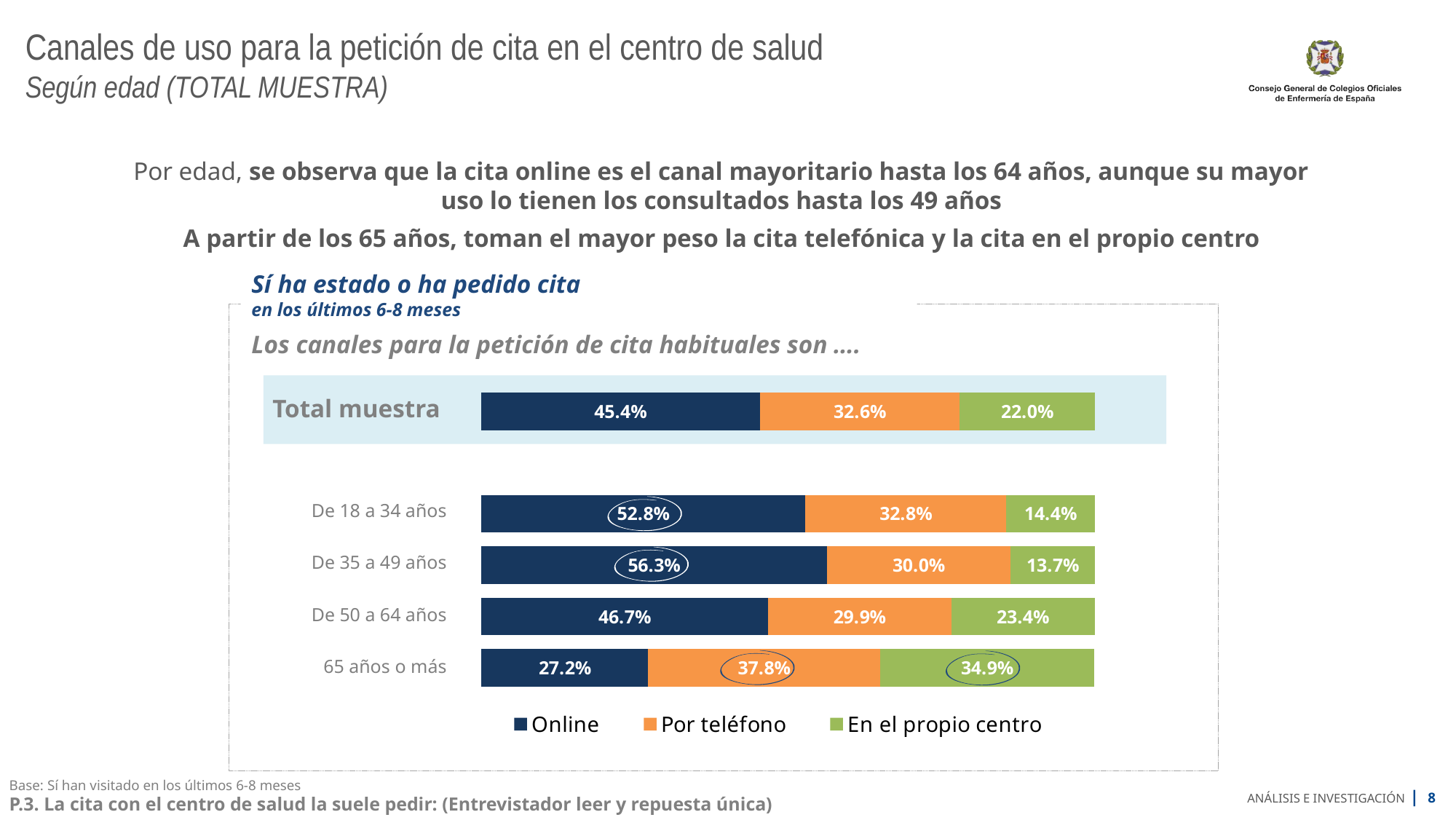
What is the 'En el propio centro' value for 'Total muestra'? 22.0% What is the 'Por teléfono' value for the '65 años o más' group? 37.8% Which is larger for the '65 años o más' group: 'Por teléfono' or 'En el propio centro'? Por teléfono What is the total of the three segments for the 'De 50 a 64 años' bar? 100.0% Which age group has the lowest 'En el propio centro' value? De 35 a 49 años How many series does the legend list? 3 What kind of chart is shown on the slide? Stacked bar chart What is the Online value for the 'De 35 a 49 años' group? 56.3% How many age groups are shown in the chart, excluding 'Total muestra'? 4 Which age group has the highest Online value? De 35 a 49 años What is the difference between the Online values for 'De 18 a 34 años' and '65 años o más'? 25.6% Which colour represents the 'Por teléfono' series in the legend? Orange